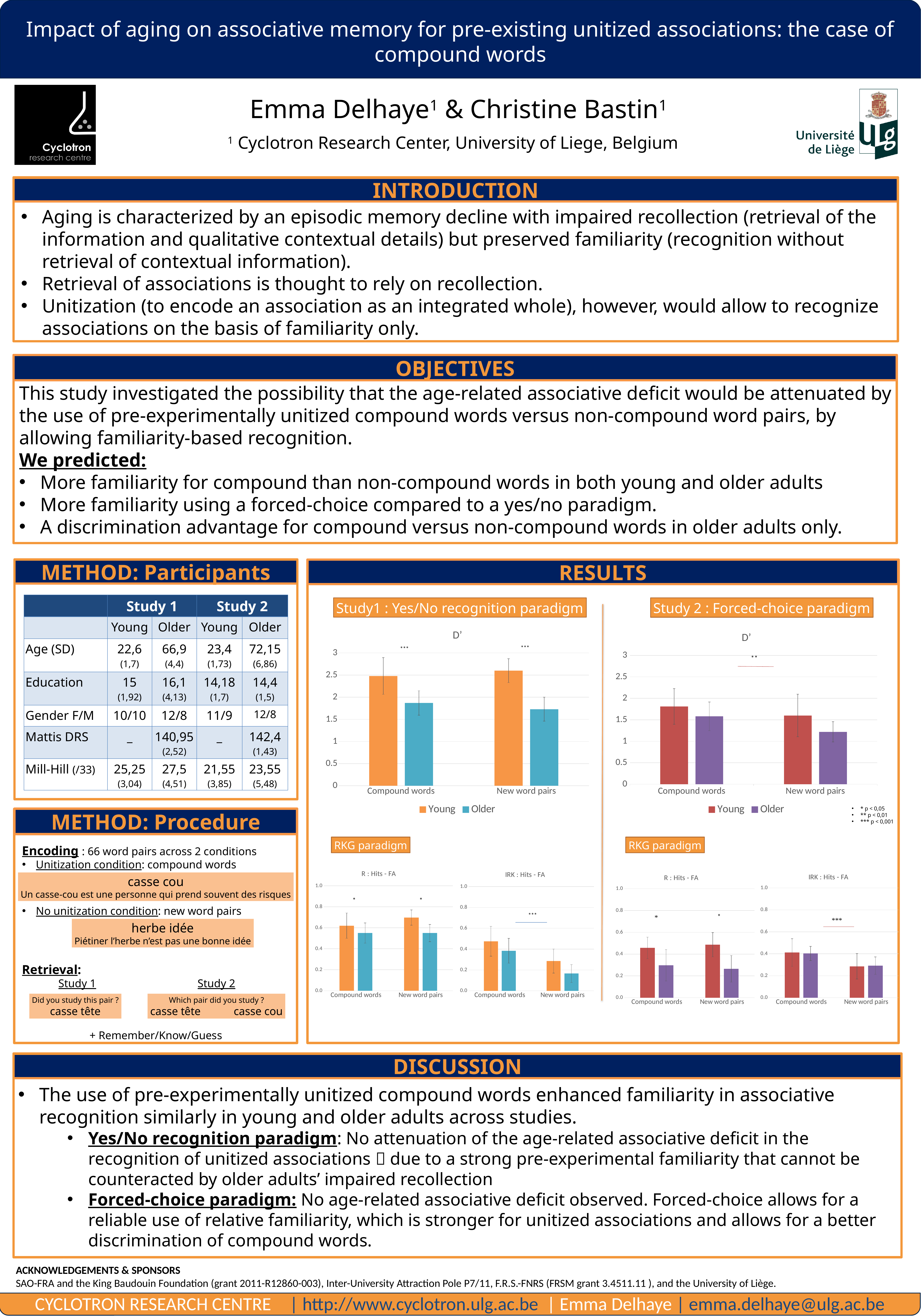
In the Study 2 RKG paradigm 'R : Hits - FA' chart, which group has the larger value for Compound words, Young or Older? Young How many series does the legend of the Study 1 D' chart list? 2 In the Study 1 D' chart, is the value for Older on New word pairs greater or less than 2? less In the Study 1 RKG paradigm 'IRK : Hits - FA' chart, is the value for Older on New word pairs greater or less than 0.4? less In the Study 2 D' chart, is the Older bar larger for Compound words or for New word pairs? Compound words In the Study 2 Forced-choice paradigm D' chart, is the value for Older on New word pairs greater or less than 1.5? less In the Study 1 D' chart, which group has the larger D' for Compound words, Young or Older? Young What kind of chart is the Study 1 Yes/No recognition paradigm D' chart? bar chart In the Study 2 D' chart, which colour represents the Older group in the legend? purple How many categories are shown on the x axis of the Study 2 D' chart? 2